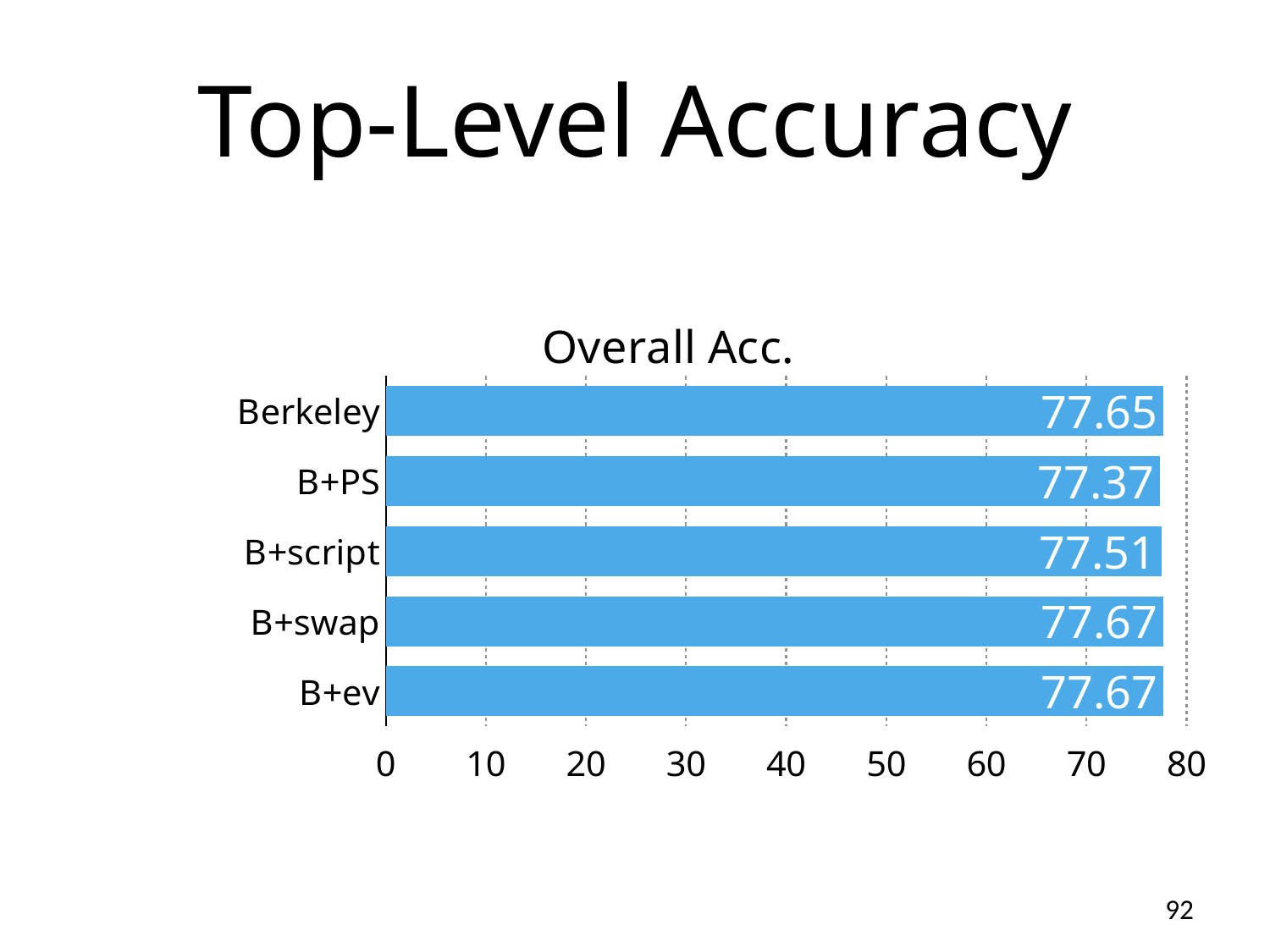
What is the value for B+swap? 77.67 What is the value for B+PS? 77.37 What is the difference between the values for B+swap and B+script? 0.16 What is the title of the chart? Overall Acc. Which category has the lowest value? B+PS Is the value for B+ev greater or less than 70? greater What is the difference between the values for Berkeley and B+PS? 0.28 What is the value for B+script? 77.51 What kind of chart is shown on the slide? bar chart What is the value for Berkeley? 77.65 How many categories are shown in the chart? 5 Which is larger, the value for Berkeley or the value for B+script? Berkeley